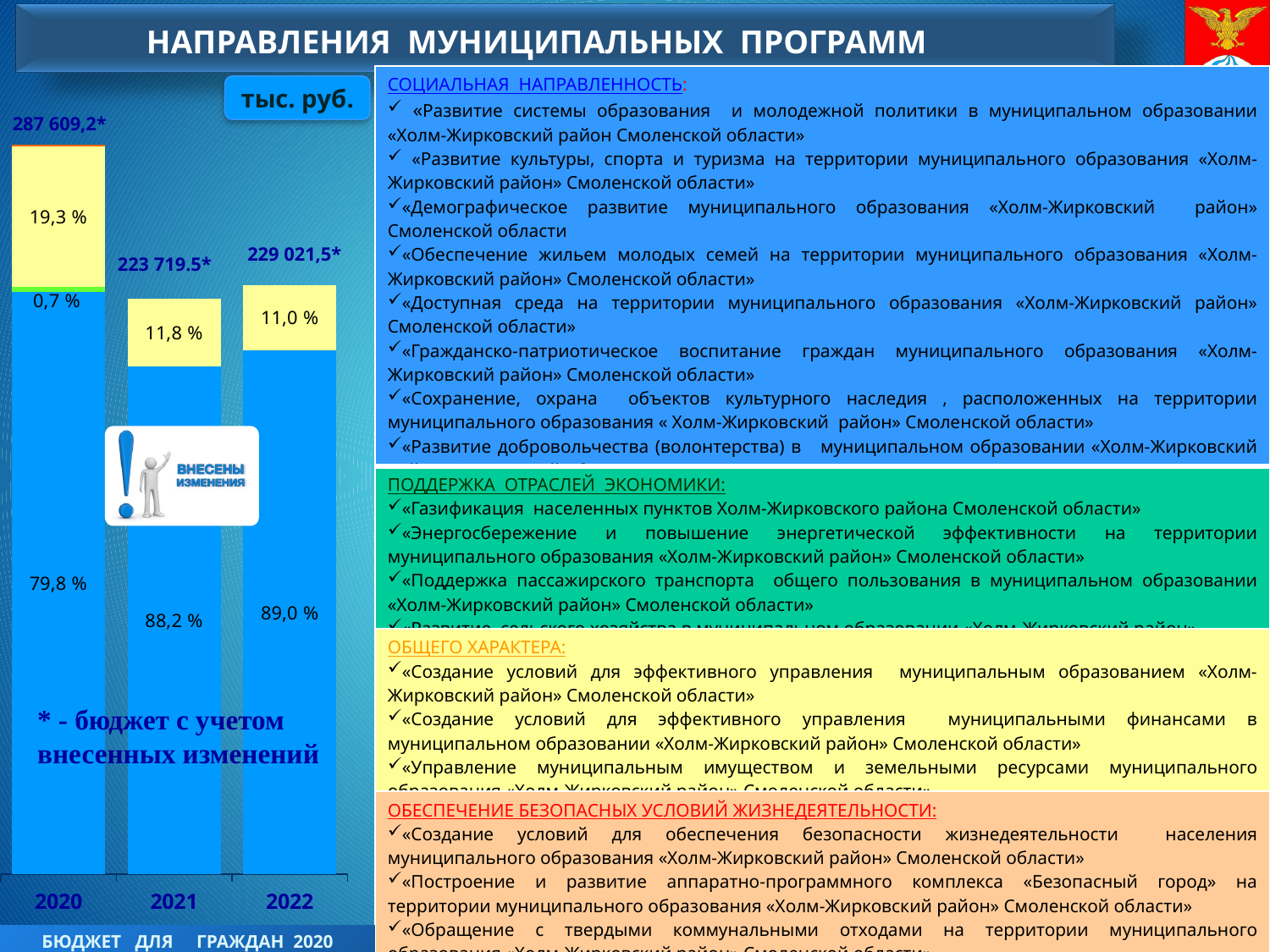
What percentage is shown in the blue (bottom) segment of the 2022 bar? 89,0 % What is the total value shown above the bar for 2021? 223 719.5* What kind of chart is shown on the left of the slide? Stacked bar chart What is the total value shown above the bar for 2020? 287 609,2* What percentage is shown in the green segment of the 2020 bar? 0,7 % Which year has the lowest total value? 2021 How many years (bars) are shown in the chart? 3 What percentage is shown in the yellow (top) segment of the 2020 bar? 19,3 % Which year has the highest total value? 2020 What unit is indicated for the values in the chart? тыс. руб. Is the blue (bottom) segment percentage larger for 2021 or for 2022? 2022 What is the total value shown above the bar for 2022? 229 021,5*